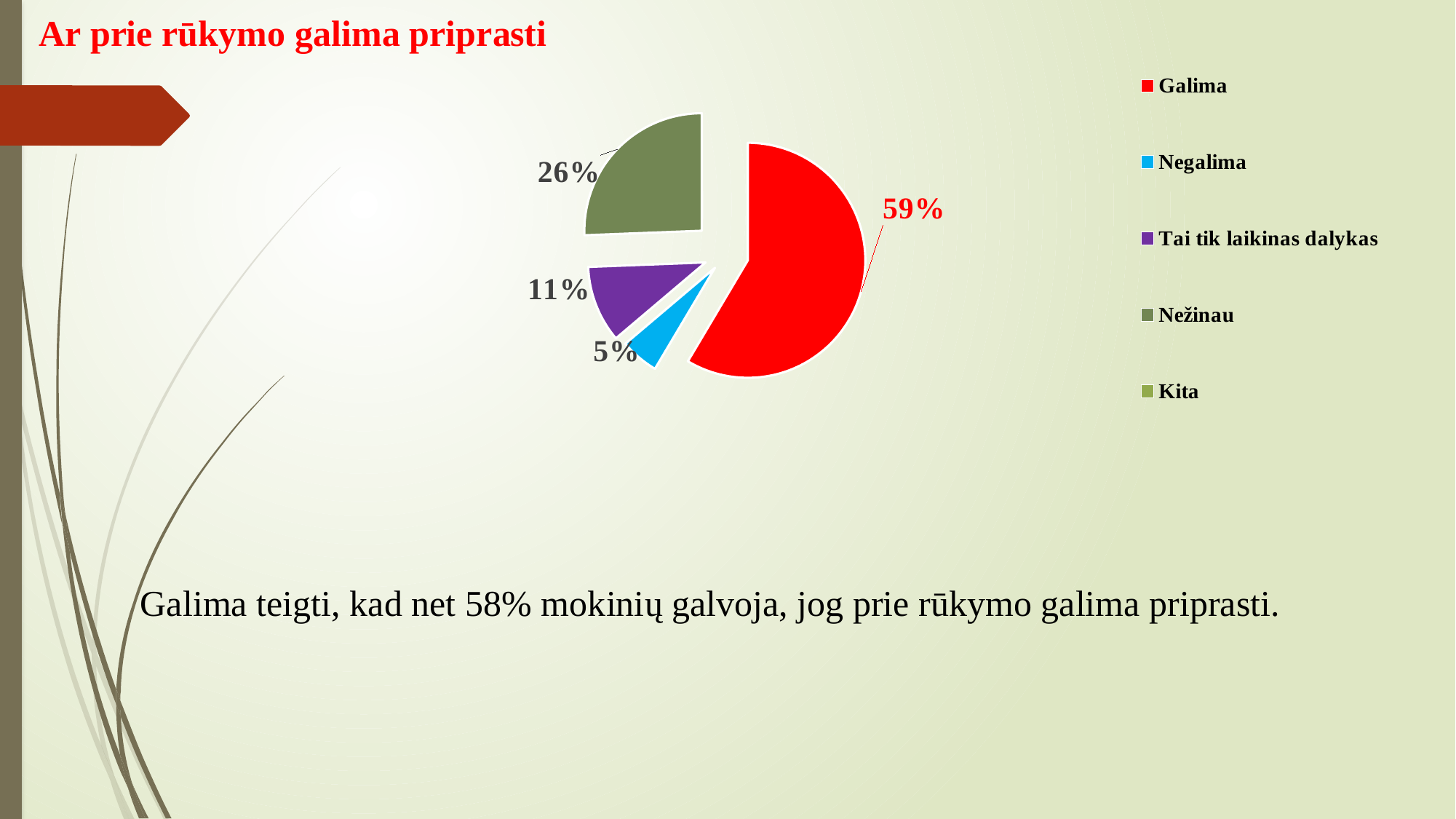
What is the difference between the 'Galima' and 'Nežinau' shares? 33 percentage points How many entries does the legend list? 5 What percentage is shown for 'Negalima'? 5% Which is larger, the 'Nežinau' share or the 'Tai tik laikinas dalykas' share? Nežinau What colour is the 'Galima' slice? Red What is the title of the slide containing the chart? Ar prie rūkymo galima priprasti What percentage is shown for 'Tai tik laikinas dalykas'? 11% What type of chart is shown on the slide? Pie chart Which labelled slice has the smallest share of the pie? Negalima What percentage is shown for 'Nežinau'? 26% Which category has the largest share of the pie? Galima What percentage of the pie is the 'Galima' slice? 59%